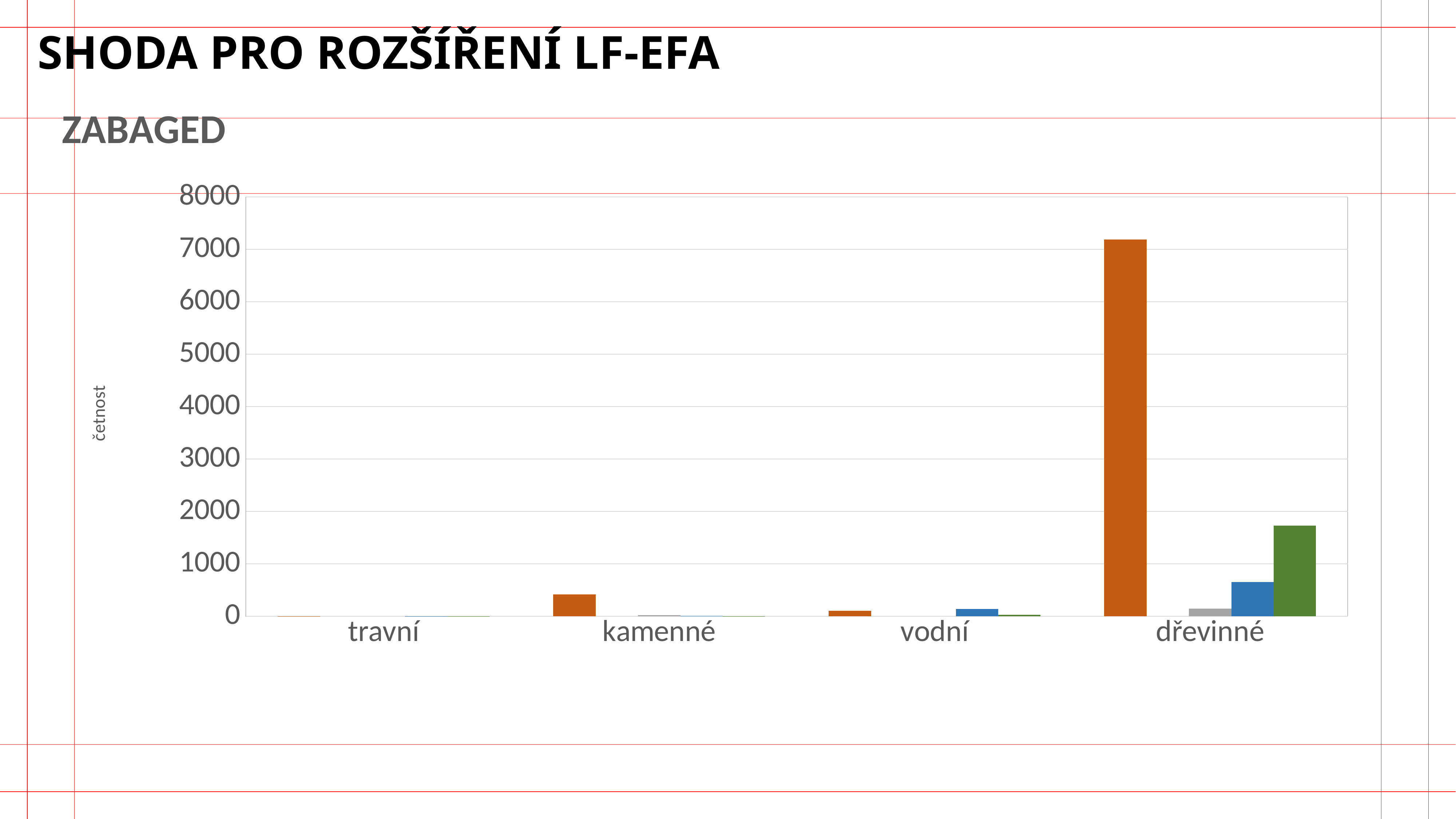
What kind of chart is shown on the slide? bar chart Which is larger: the orange bar for dřevinné or the orange bar for kamenné? dřevinné Within the dřevinné category, which is larger: the green bar or the blue bar? green bar Is the value of the blue bar for dřevinné greater or less than 1000? less Is the value of the orange bar for kamenné greater or less than 1000? less Is the value of the green bar for dřevinné greater or less than 1000? greater What is the label of the vertical axis of the chart? četnost How many categories are shown on the x axis of the chart? 4 Which category has the tallest bar in the chart? dřevinné Which category has the smallest bars overall in the chart? travní